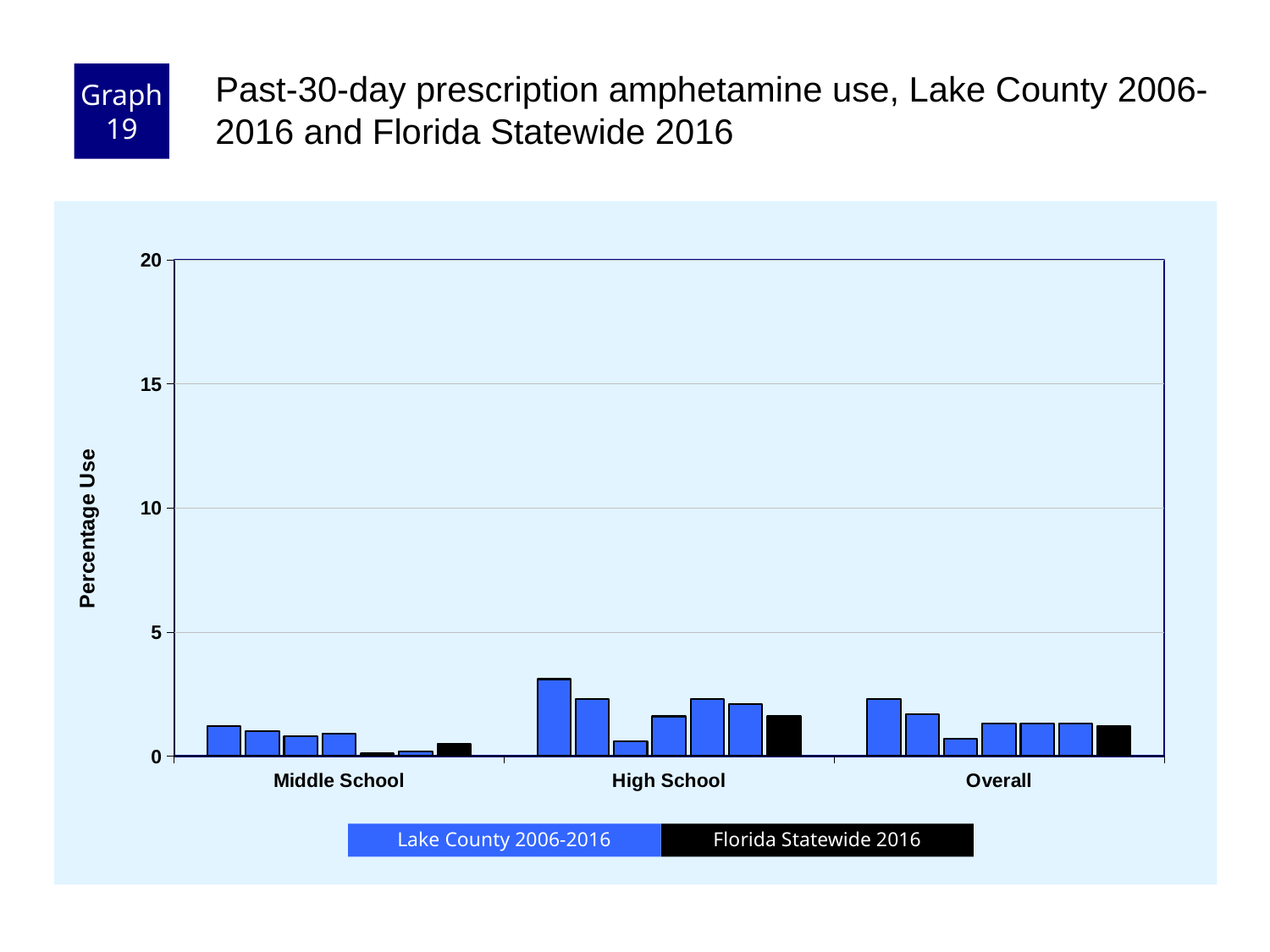
Which is larger, the Florida Statewide 2016 bar for High School or the Florida Statewide 2016 bar for Middle School? High School Is the Florida Statewide 2016 value for High School greater or less than 5? less Which category group has the lowest bars overall? Middle School How many series does the legend list? 2 Is the tallest Lake County 2006-2016 bar for High School greater or less than 5? less Do the Lake County 2006-2016 bars for Middle School generally rise or fall from left to right? fall Which colour represents Florida Statewide 2016 in the legend? black What is the label on the y axis? Percentage Use What kind of chart is shown on the slide? bar chart Which category group contains the tallest bar? High School How many categories are shown on the x axis? 3 Is the Florida Statewide 2016 value for Middle School greater or less than 5? less